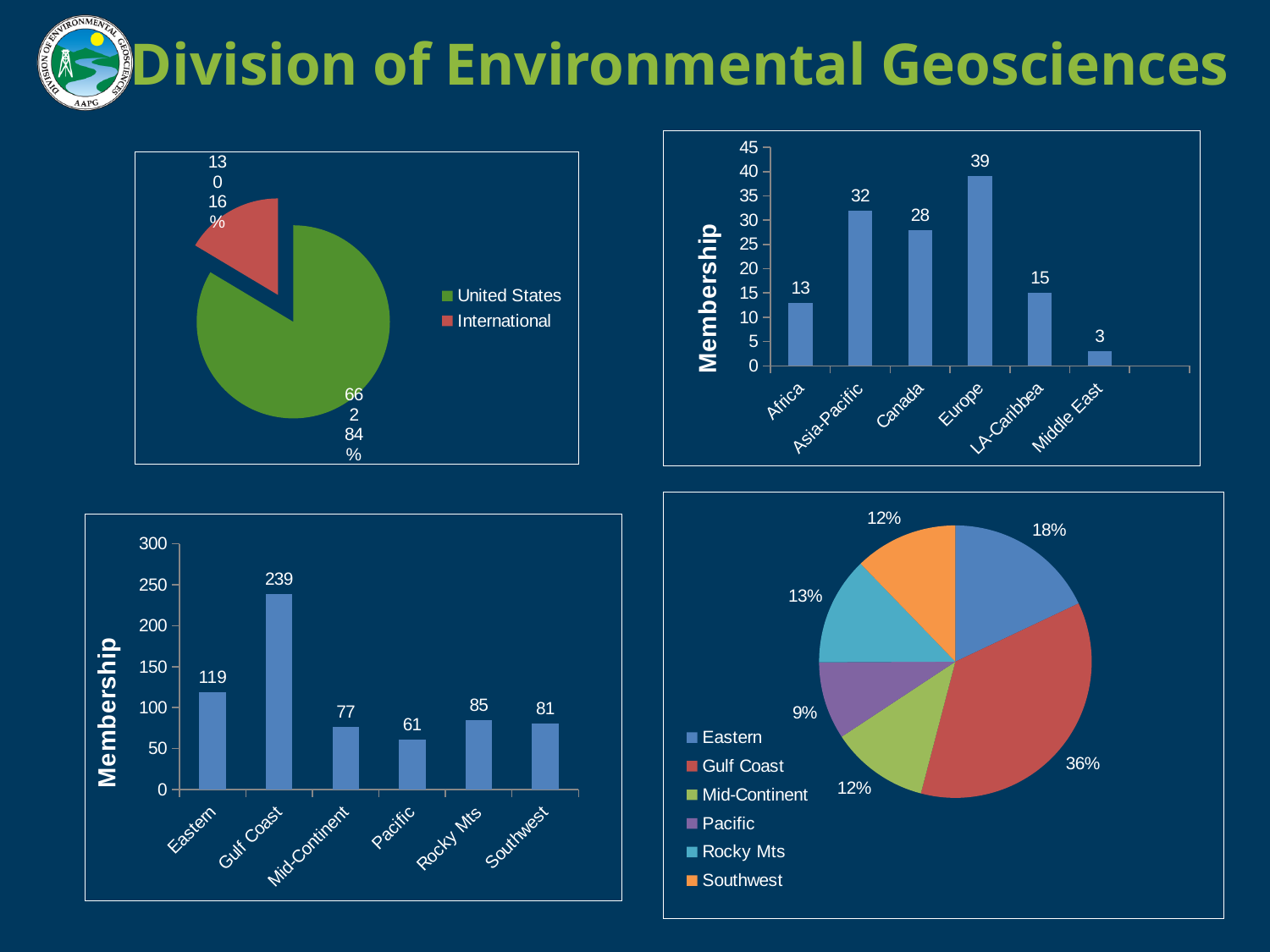
In the top-right bar chart, what is the membership value for Europe? 39 In the bottom-left bar chart, what is the difference in membership between Eastern and Mid-Continent? 42 In the bottom-right pie chart, what share does Gulf Coast have? 36% In the bottom-left bar chart, what is the membership value for Gulf Coast? 239 In the top-right bar chart, which region has the lowest membership? Middle East What kind of chart is the bottom-left chart? bar chart In the top-left pie chart, what percentage share is labelled for United States? 84% In the bottom-left bar chart, which region has the lowest membership? Pacific How many entries does the legend of the bottom-right pie chart list? 6 In the top-right bar chart, what is the difference in membership between Asia-Pacific and Canada? 4 How many regions are shown in the top-right bar chart? 6 In the bottom-left bar chart, which is larger, the membership for Rocky Mts or for Southwest? Rocky Mts